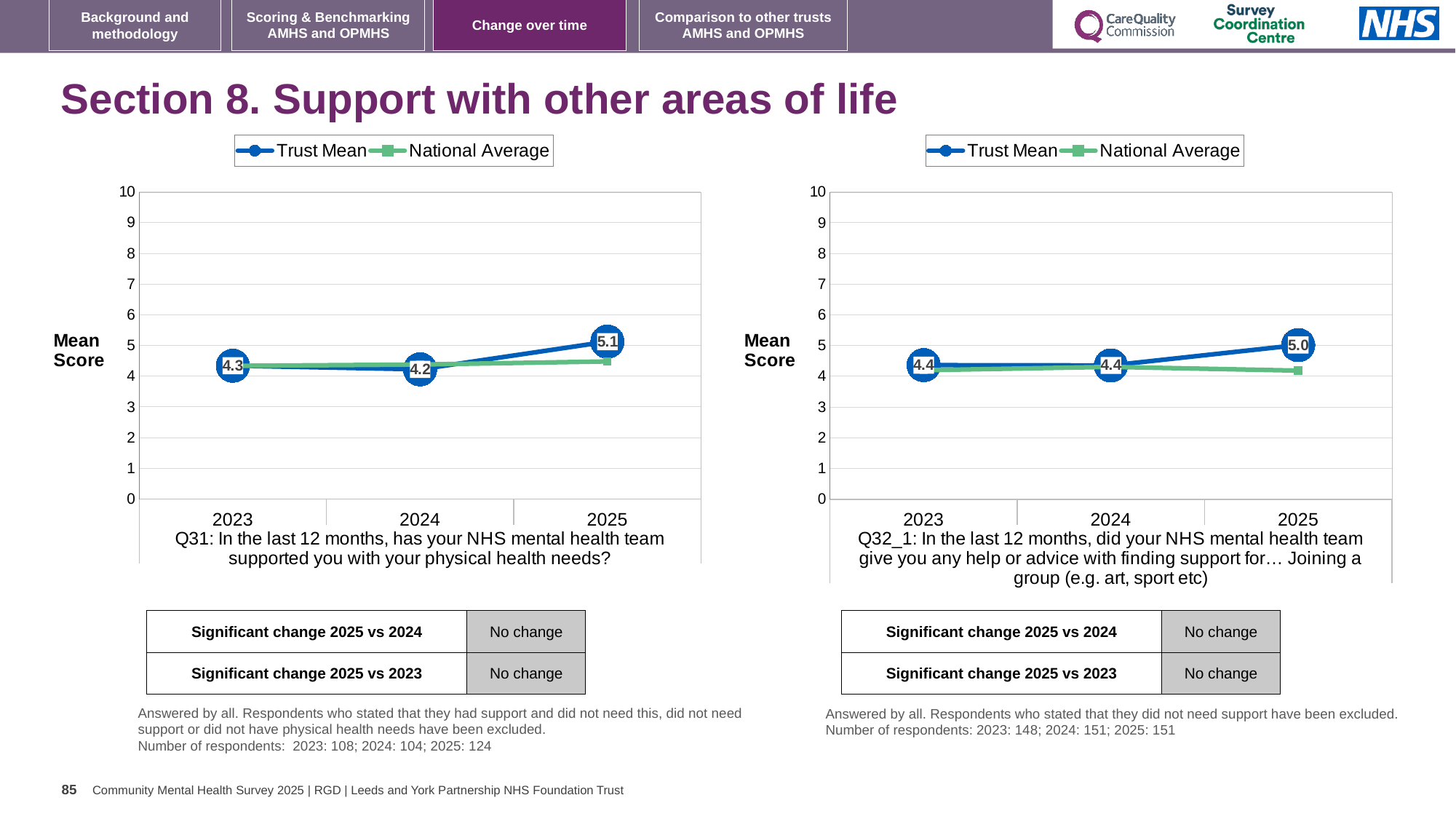
What kind of chart is the Q31 chart on the left? Line chart How many series does the legend of the Q32_1 chart on the right list? 2 In the Q32_1 chart on the right, is the National Average value for 2025 greater or less than 5? less In the Q32_1 chart on the right, what is the difference between the Trust Mean scores for 2025 and 2023? 0.6 In the Q31 chart on the left, what is the Trust Mean score for 2025? 5.1 In the Q31 chart on the left, which year has the lowest Trust Mean score? 2024 In the Q31 chart on the left, what is the difference between the Trust Mean scores for 2025 and 2024? 0.9 In the Q31 chart on the left, what is the Trust Mean score for 2024? 4.2 In the Q32_1 chart on the right, what is the Trust Mean score for 2025? 5.0 In the Q32_1 chart on the right, which is higher in 2025: the Trust Mean or the National Average? Trust Mean How many years are plotted on the x axis of the Q31 chart on the left? 3 In the Q31 chart on the left, which year has the highest Trust Mean score? 2025